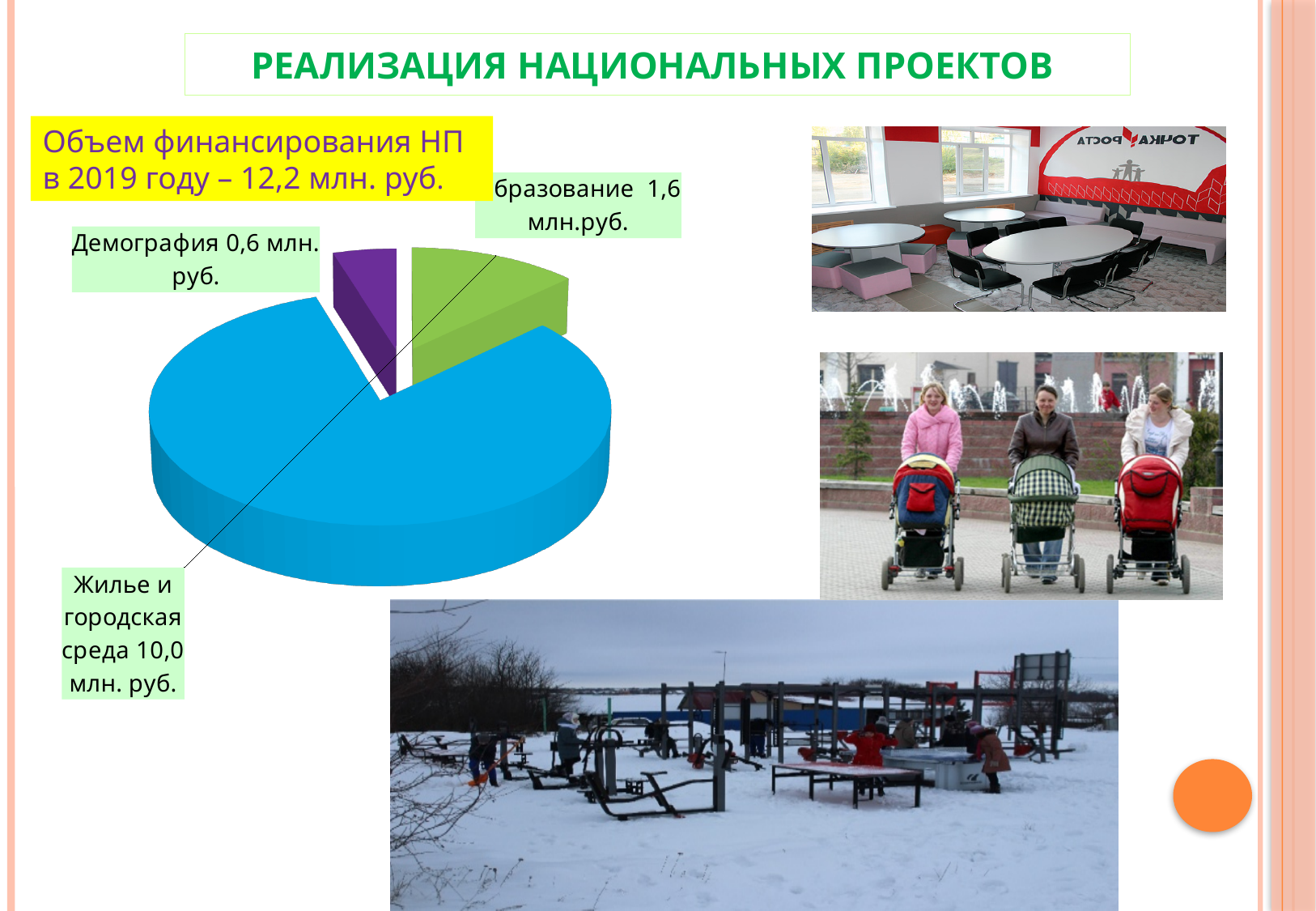
What type of chart is shown on the slide? Pie chart What is the total volume of national project funding in 2019 shown on the slide? 12,2 млн. руб. What is the difference between the funding for Образование and Демография? 1,0 млн. руб. How many slices does the pie chart have? 3 What is the funding amount for Демография in the pie chart? 0,6 млн. руб. Which category has the largest slice in the pie chart? Жилье и городская среда What is the funding amount for Жилье и городская среда in the pie chart? 10,0 млн. руб. Which received more funding, Образование or Демография? Образование Which category has the smallest slice in the pie chart? Демография What is the difference between the funding for Жилье и городская среда and Образование? 8,4 млн. руб. What colour is the slice for Демография in the pie chart? Purple What is the funding amount for Образование in the pie chart? 1,6 млн.руб.